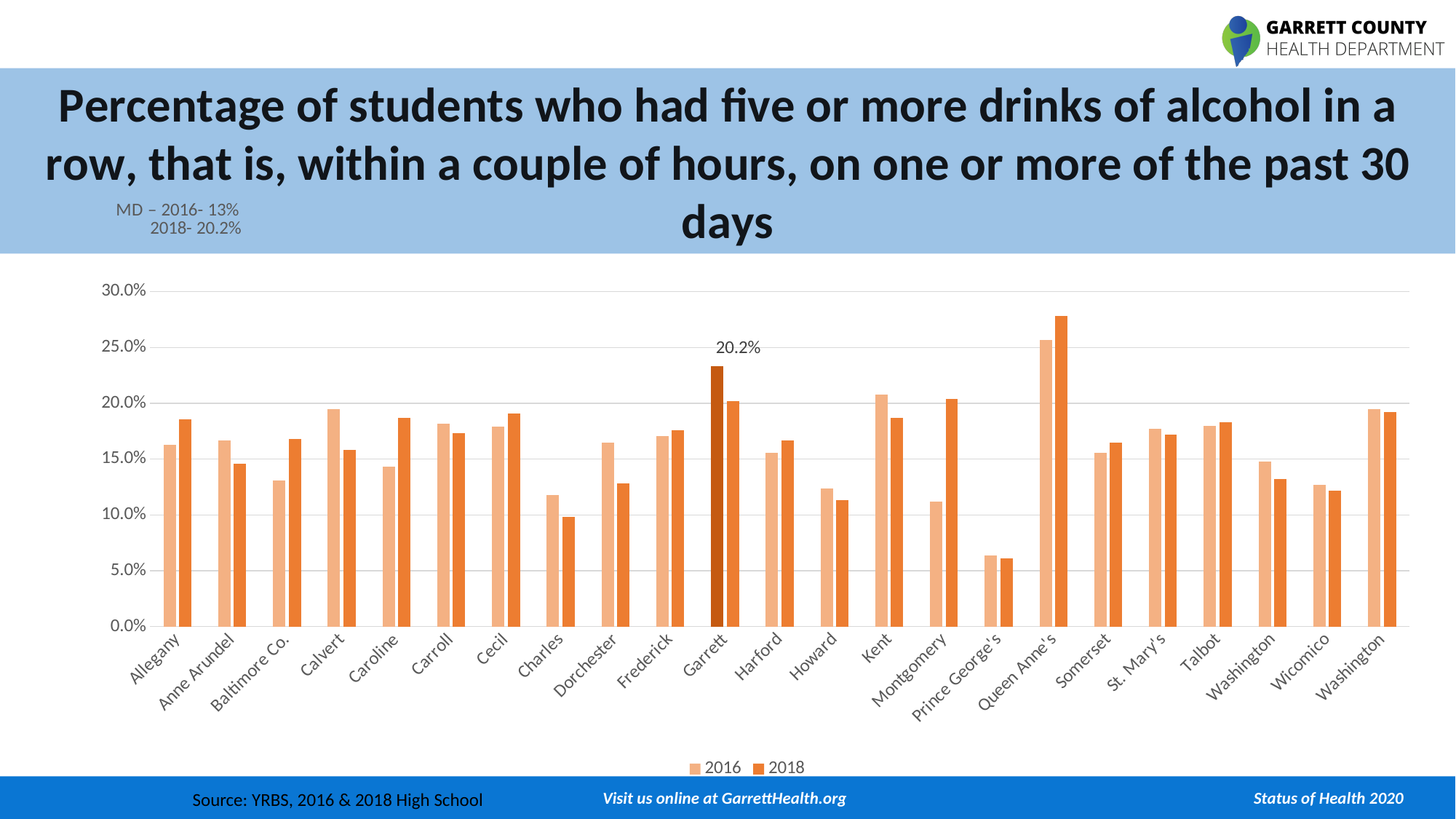
Is the 2018 value for Queen Anne's greater or less than 25.0%? greater What are the two entries in the chart legend? 2016 and 2018 Which county has the highest value for 2018? Queen Anne's What kind of chart is shown on the slide? Bar chart What is the labelled value for Garrett in 2018? 20.2% Is the 2016 value for Prince George's greater or less than 10.0%? less Is the 2016 value for Garrett greater or less than 20.0%? greater Which county has the highest value for 2016? Queen Anne's For Montgomery, which year has the larger value, 2016 or 2018? 2018 How many series does the legend list? 2 For Garrett, which year has the larger value, 2016 or 2018? 2016 Which county has the lowest value for 2018? Prince George's